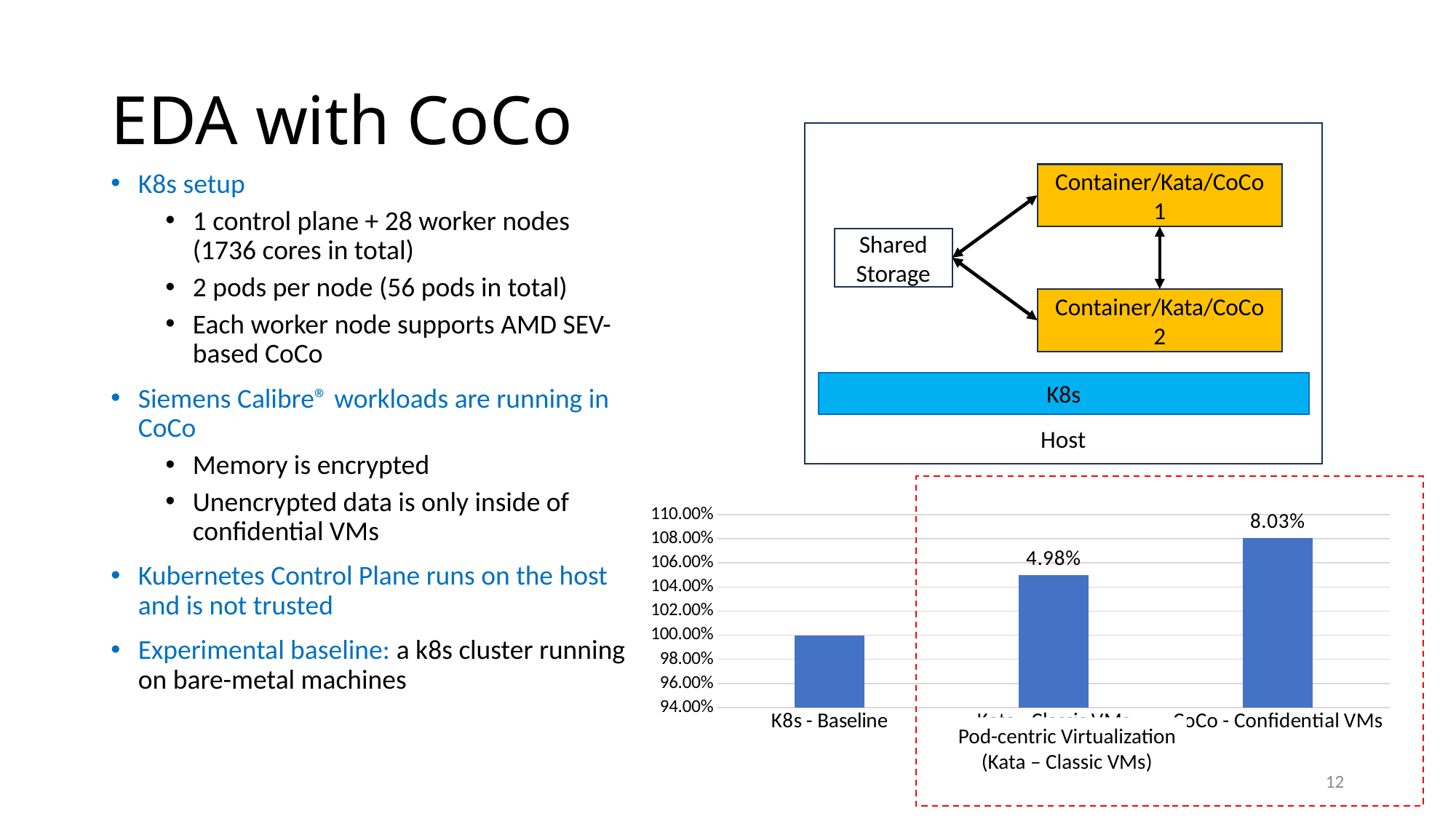
Which category has the tallest bar in the chart? CoCo - Confidential VMs What data label is printed above the CoCo - Confidential VMs bar? 8.03% Is the middle bar (Kata - Classic VMs) greater or less than 106.00% on the y axis? less Is the CoCo - Confidential VMs bar greater or less than 106.00% on the y axis? greater Which category has the shortest bar in the chart? K8s - Baseline Do the bar heights rise or fall from left to right across the chart? rise Which bar is taller: Kata - Classic VMs or CoCo - Confidential VMs? CoCo - Confidential VMs What is the difference between the data labels printed above the CoCo - Confidential VMs bar and the Kata - Classic VMs bar? 3.05% Which y-axis tick does the K8s - Baseline bar reach? 100.00% What kind of chart is shown at the bottom right of the slide? bar chart What data label is printed above the middle bar (Kata - Classic VMs)? 4.98% How many bars does the chart at the bottom right of the slide have? 3